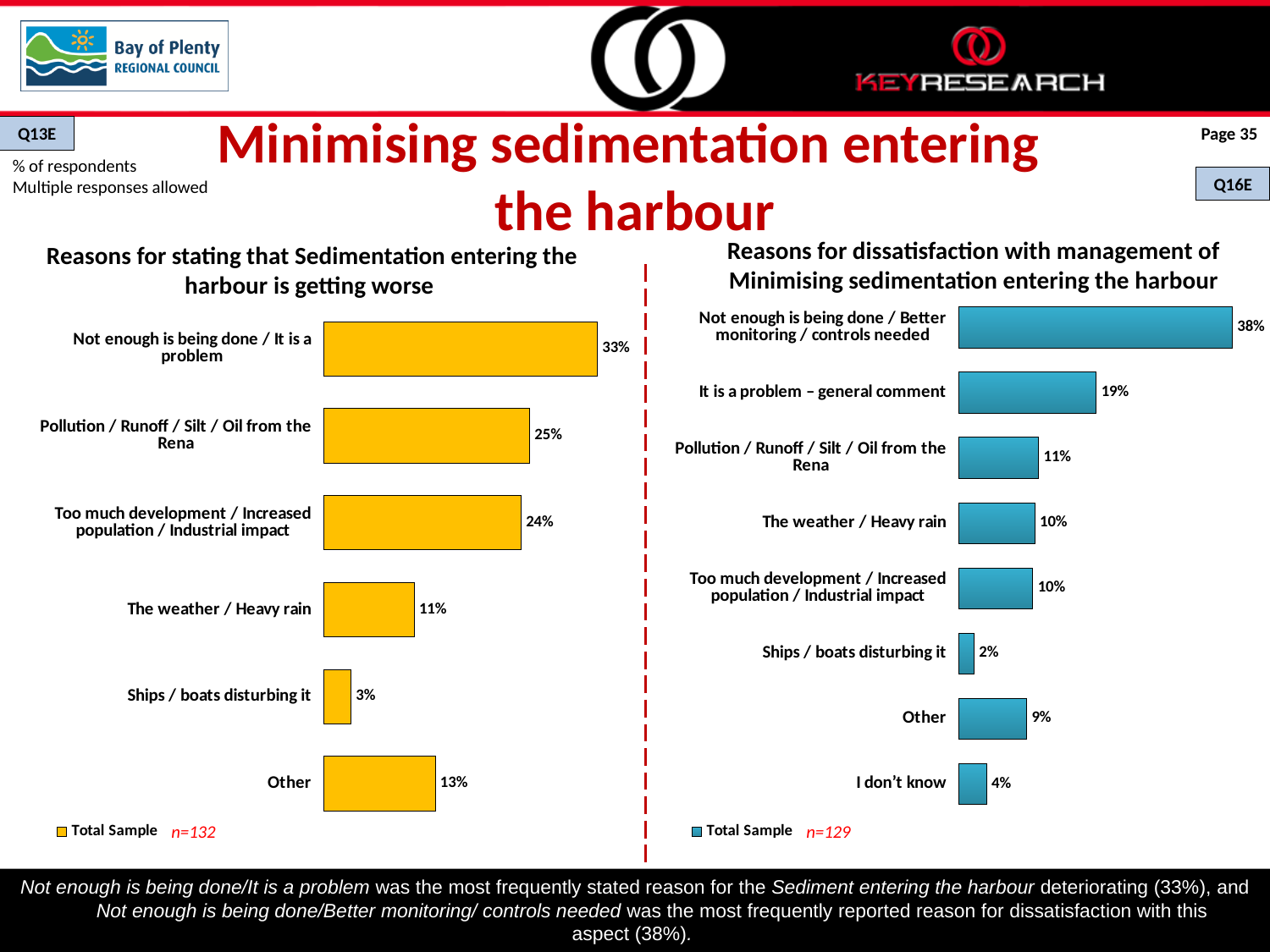
In the left chart (Reasons for stating that Sedimentation entering the harbour is getting worse), which category has the highest value? Not enough is being done / It is a problem In the right chart (Reasons for dissatisfaction with management of Minimising sedimentation entering the harbour), what is the value for 'It is a problem – general comment'? 19% How many series does the legend of the right chart (Reasons for dissatisfaction with management of Minimising sedimentation entering the harbour) list? 1 In the right chart (Reasons for dissatisfaction with management of Minimising sedimentation entering the harbour), which category has the lowest value? Ships / boats disturbing it In the left chart (Reasons for stating that Sedimentation entering the harbour is getting worse), what is the value for 'Pollution / Runoff / Silt / Oil from the Rena'? 25% What type of chart is the left chart (Reasons for stating that Sedimentation entering the harbour is getting worse)? Bar chart In the right chart (Reasons for dissatisfaction with management of Minimising sedimentation entering the harbour), which is larger: 'Other' or 'I don't know'? Other In the right chart (Reasons for dissatisfaction with management of Minimising sedimentation entering the harbour), how many categories are shown? 8 In the right chart (Reasons for dissatisfaction with management of Minimising sedimentation entering the harbour), what is the difference between 'Not enough is being done / Better monitoring / controls needed' and 'It is a problem – general comment'? 19% In the left chart (Reasons for stating that Sedimentation entering the harbour is getting worse), how many categories are shown? 6 In the left chart (Reasons for stating that Sedimentation entering the harbour is getting worse), which category has the lowest value? Ships / boats disturbing it In the left chart (Reasons for stating that Sedimentation entering the harbour is getting worse), what is the difference between 'Not enough is being done / It is a problem' and 'Other'? 20%